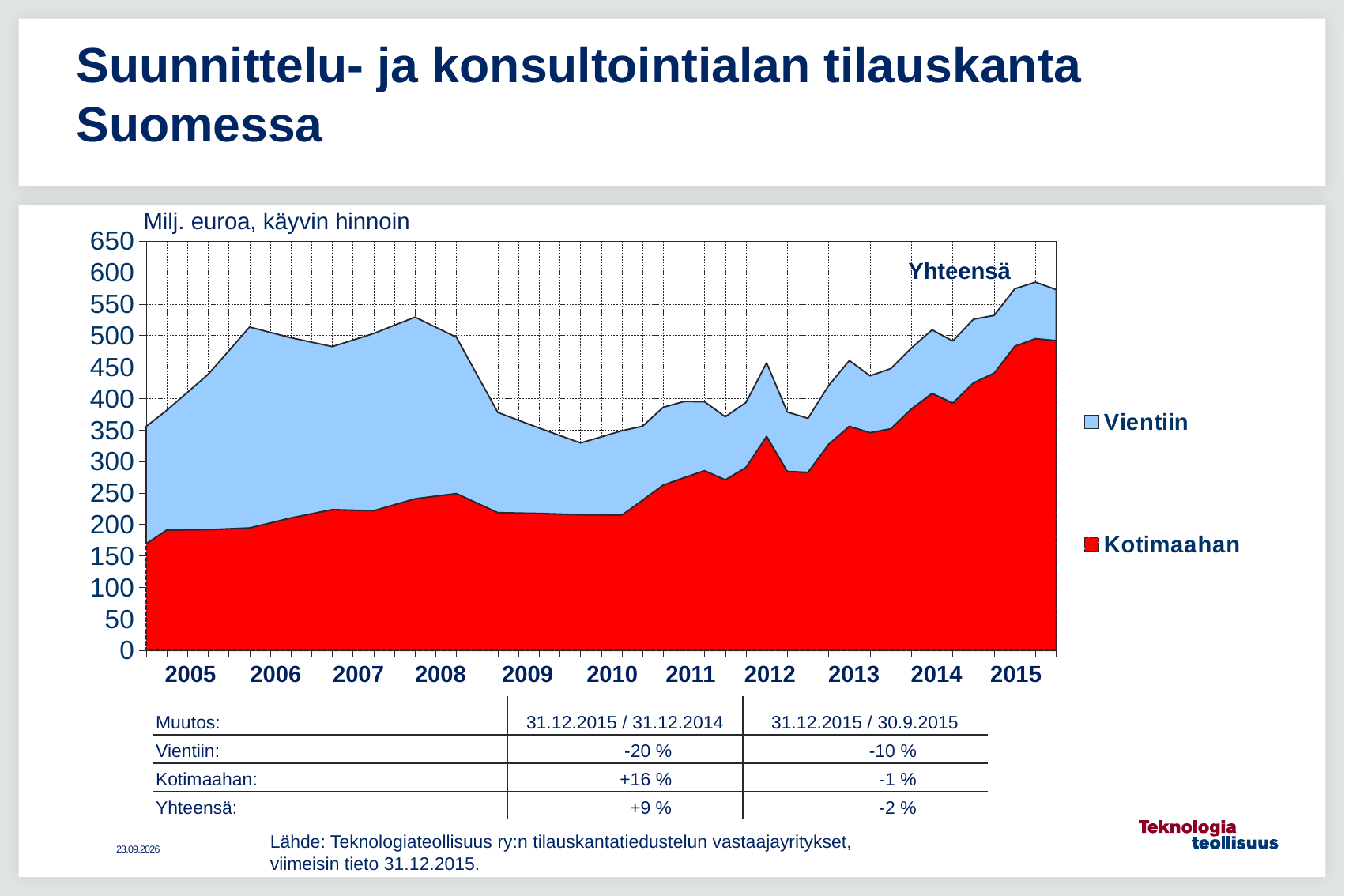
How many years are labelled on the chart's x axis? 11 Is the total (Yhteensä) value at the end of 2015 greater or less than 550? greater What is the highest value shown on the chart's y axis? 650 Is the Kotimaahan value at the end of 2015 greater or less than 450? greater Does the Kotimaahan series rise or fall between 2012 and 2015? rise What are the two series named in the chart legend? Vientiin and Kotimaahan At the end of 2015, which series is larger, Vientiin or Kotimaahan? Kotimaahan How many series does the chart legend list? 2 What unit is stated above the chart's y axis? Milj. euroa, käyvin hinnoin Is the total (Yhteensä) value at its low point in 2010 greater or less than 350? less What kind of chart is shown on the slide? Stacked area chart